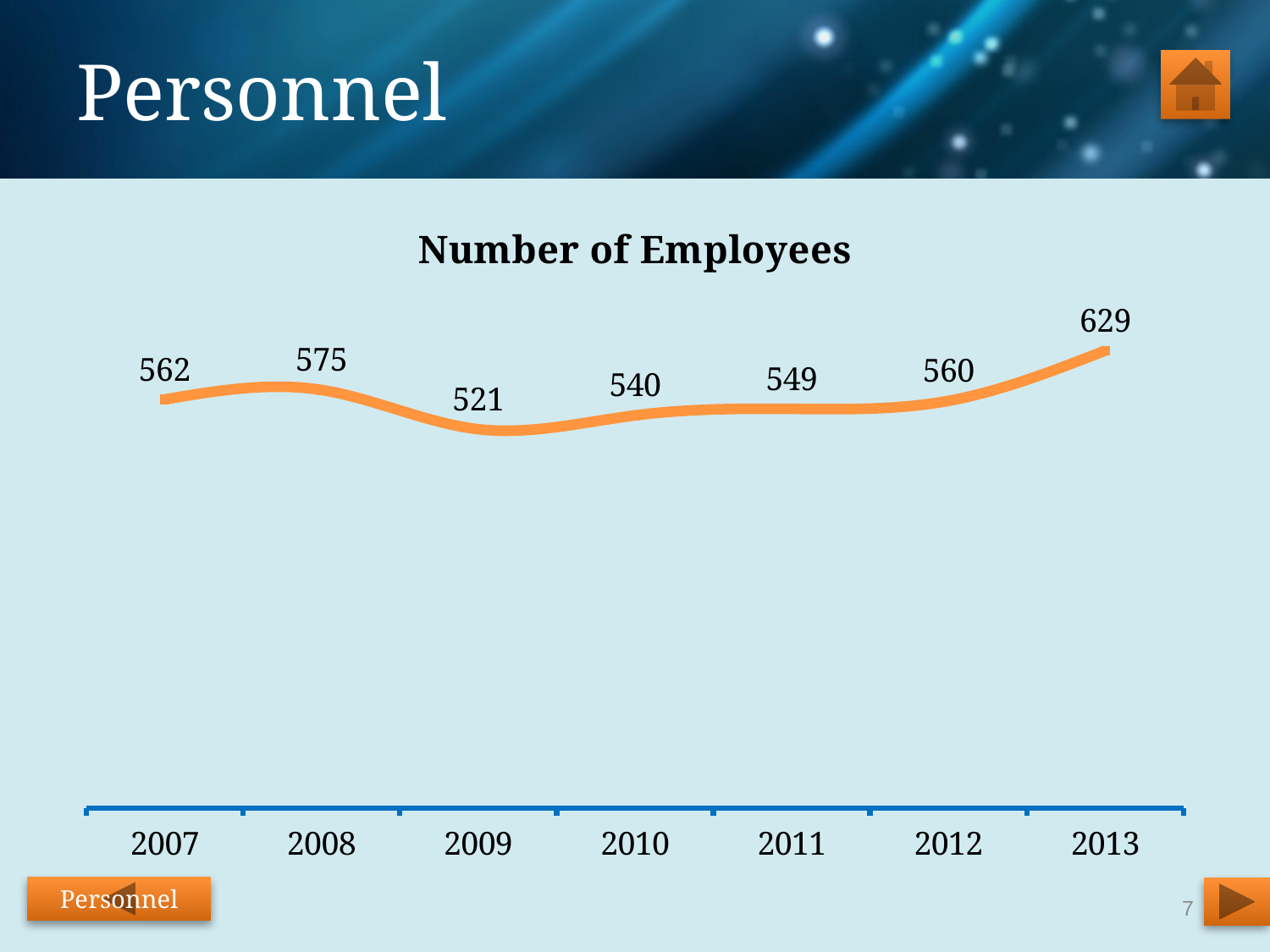
What is the difference in the number of employees between 2008 and 2009? 54 What kind of chart is shown on the slide? Line chart What is the number of employees in 2011? 549 What is the difference in the number of employees between 2013 and 2012? 69 What is the title of the chart? Number of Employees Does the number of employees rise or fall from 2009 to 2013? Rise Which year has more employees, 2007 or 2010? 2007 Which year has the highest number of employees? 2013 Which year has the lowest number of employees? 2009 How many years are shown on the x axis of the chart? 7 What is the number of employees in 2009? 521 What is the number of employees in 2013? 629